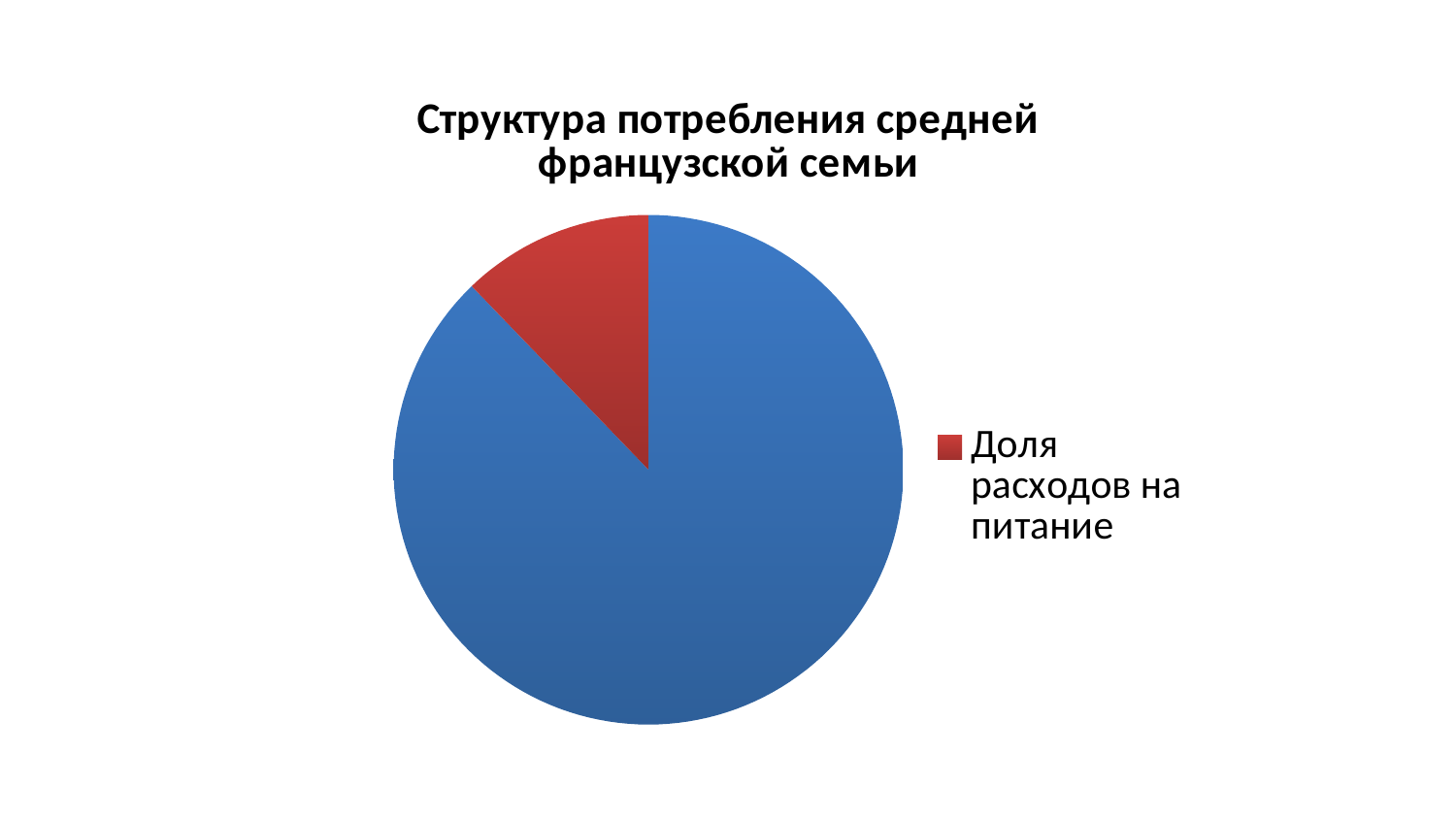
How many entries does the legend list? 1 How many slices does the pie chart have? 2 What kind of chart is shown on the slide? pie chart Which slice is larger, the blue slice or the red slice labelled "Доля расходов на питание"? the blue slice What colour is the slice labelled "Доля расходов на питание" in the legend? red What is the title of the chart? Структура потребления средней французской семьи Which slice of the pie is the smallest? Доля расходов на питание